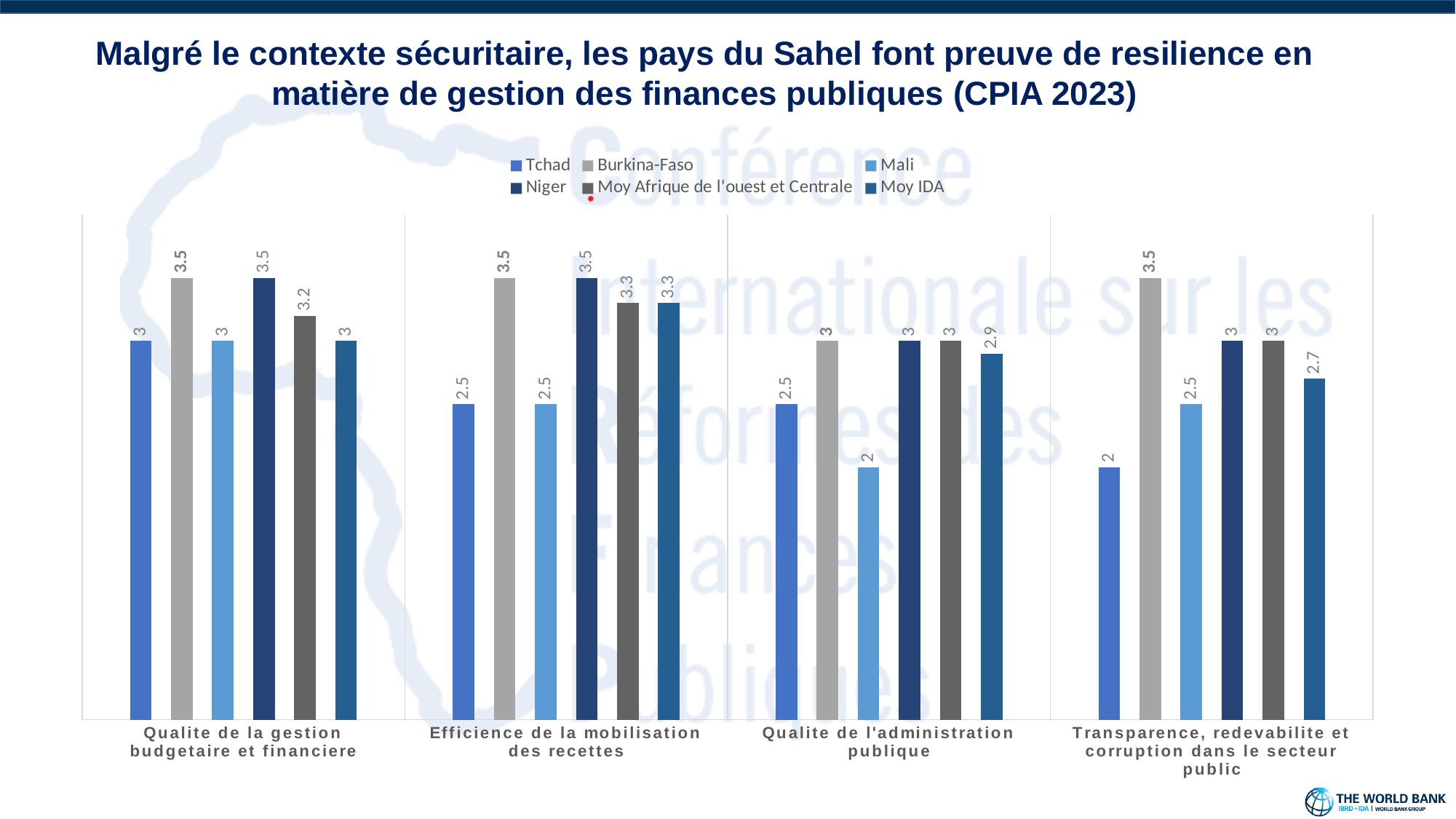
What is the value for Moy IDA in the category "Transparence, redevabilite et corruption dans le secteur public"? 2.7 How many categories are shown on the x axis of the chart? 4 What is the difference between the Burkina-Faso value and the Tchad value in the category "Transparence, redevabilite et corruption dans le secteur public"? 1.5 What is the value for Tchad in the category "Efficience de la mobilisation des recettes"? 2.5 What is the difference between the Niger value and the Mali value in the category "Efficience de la mobilisation des recettes"? 1 What kind of chart is shown on the slide? Bar chart Which series has the lowest value in the category "Qualite de l'administration publique"? Mali Which series has the lowest value in the category "Transparence, redevabilite et corruption dans le secteur public"? Tchad In the category "Qualite de l'administration publique", which is larger: the value for Moy IDA or the value for Tchad? Moy IDA What is the value for Mali in the category "Qualite de l'administration publique"? 2 How many series does the legend list? 6 What is the value for Moy Afrique de l'ouest et Centrale in the category "Qualite de la gestion budgetaire et financiere"? 3.2